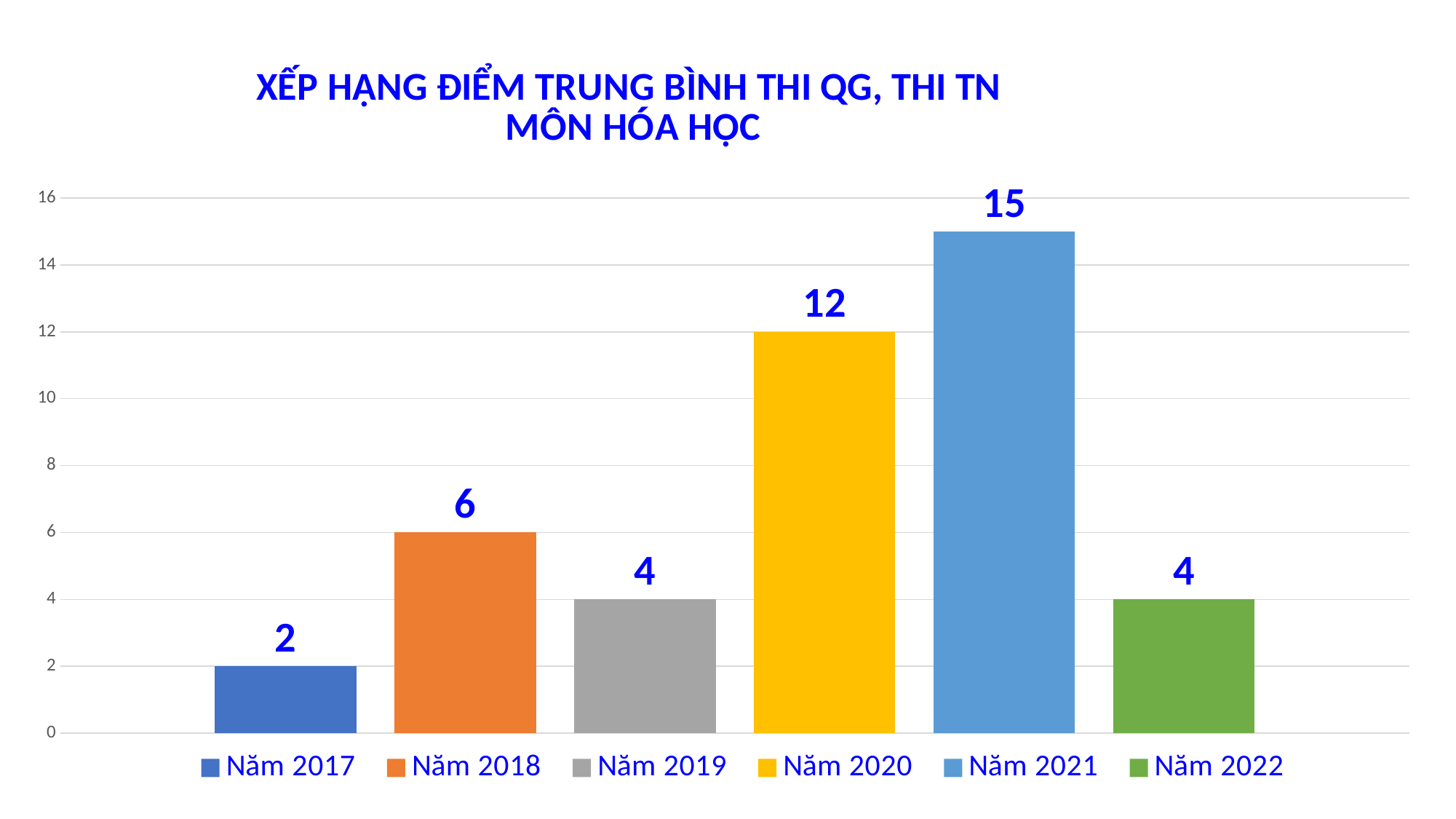
What is the value for Năm 2017? 2 What is the value for Năm 2020? 12 Which year has the highest value? Năm 2021 What kind of chart is shown on the slide? Bar chart How many bars are plotted in the chart? 6 What is the difference between the values for Năm 2021 and Năm 2018? 9 What colour is the bar for Năm 2020? Yellow Is the value for Năm 2021 greater or less than 14? greater How many entries does the legend list? 6 Which year has the lowest value? Năm 2017 What is the value for Năm 2022? 4 Which is larger, the value for Năm 2018 or the value for Năm 2019? Năm 2018